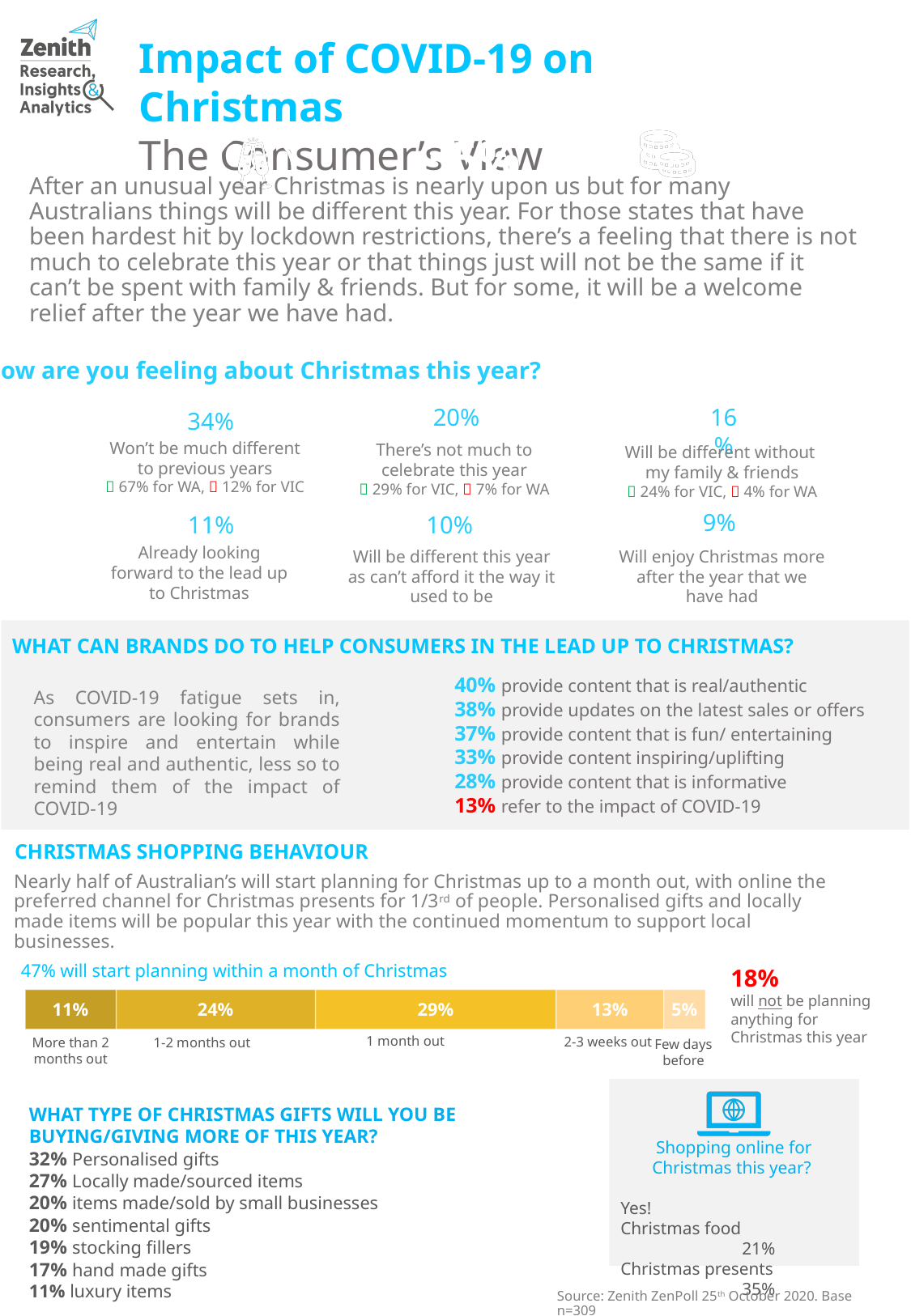
In the Christmas planning bar chart, which planning period has the lowest percentage? Few days before How many planning-period segments does the Christmas planning bar chart show? 5 In the Christmas planning bar chart, do the values rise or fall from 1 month out to few days before? fall In the Christmas planning bar chart, which is larger: 1-2 months out or 2-3 weeks out? 1-2 months out What kind of chart is used to show when people will start planning for Christmas? bar chart In the Christmas planning bar chart, what percentage will start planning 2-3 weeks out? 13% In the Christmas planning bar chart, what is the difference between the 1 month out and 1-2 months out percentages? 5% In the Christmas planning bar chart, which planning period has the highest percentage? 1 month out In the Christmas planning bar chart, what percentage will start planning 1 month out? 29% In the Christmas planning bar chart, what is the total of all the segments? 82% In the Christmas planning bar chart, what percentage will start planning a few days before? 5% In the Christmas planning bar chart, what percentage will start planning more than 2 months out? 11%